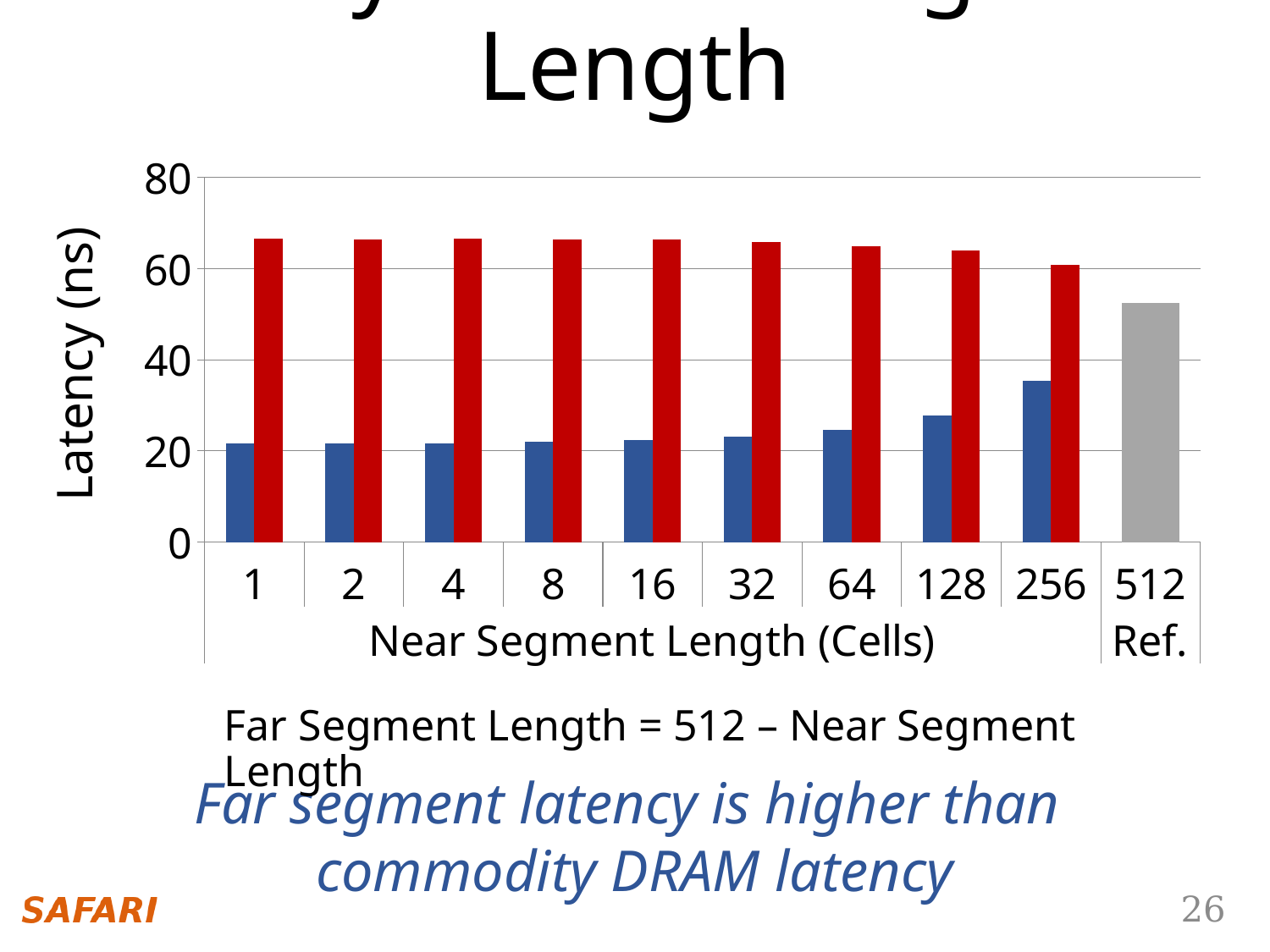
Is the gray 512 Ref. bar greater or less than 60? less Among the blue bars, which near segment length has the highest latency? 256 What kind of chart is shown on the slide? bar chart Is the blue bar for near segment length 128 greater or less than 20? greater Is the blue bar for near segment length 256 greater or less than 40? less How many near segment length values are shown on the x axis, excluding the 512 Ref. bar? 9 Do the blue bars rise or fall as near segment length increases from 1 to 256? rise Among the red bars, which near segment length has the lowest latency? 256 What is the title of the y axis? Latency (ns) What is the title of the x axis? Near Segment Length (Cells)